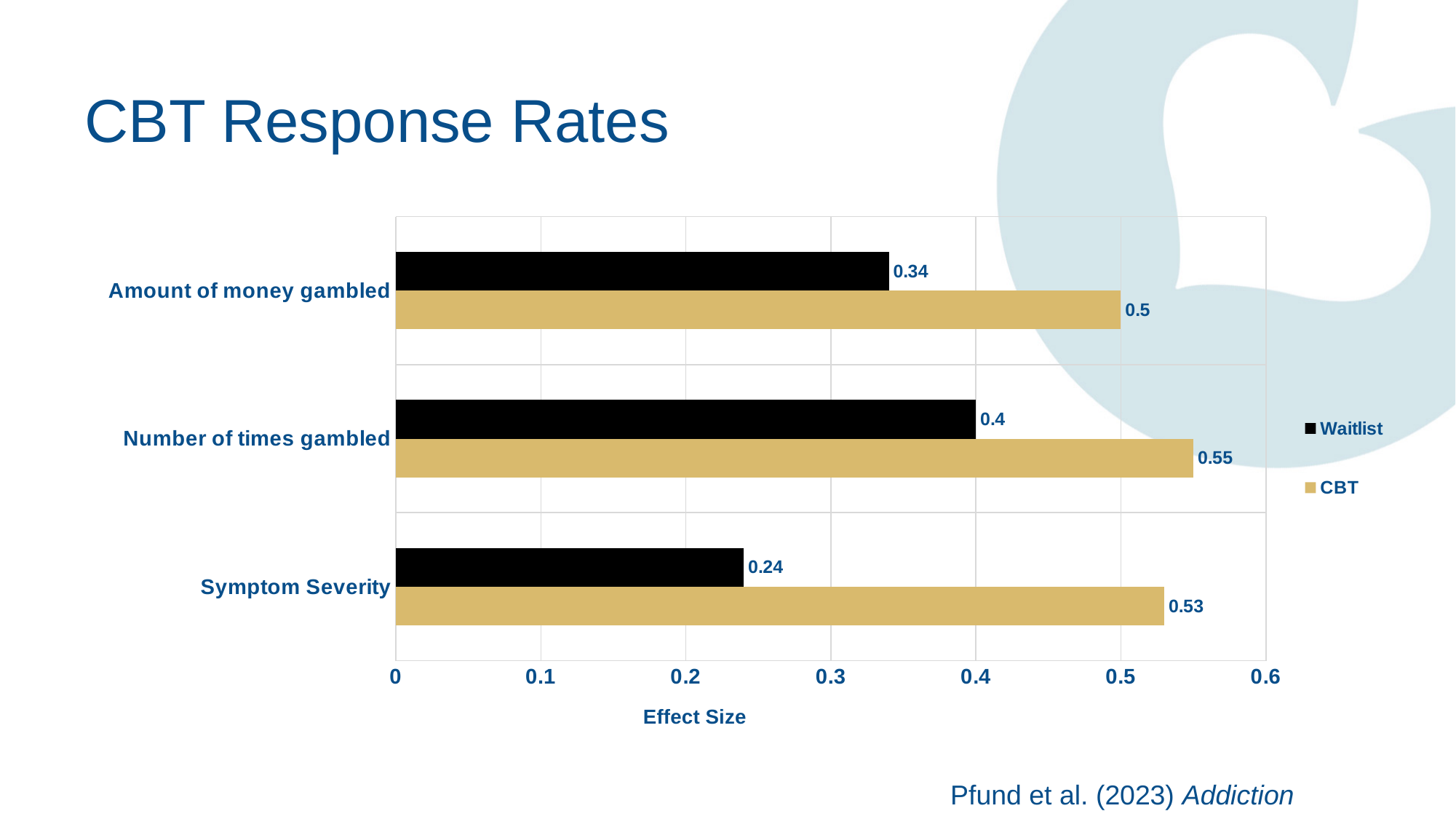
Which is larger for Number of times gambled, the CBT or the Waitlist effect size? CBT What is the difference between the CBT and Waitlist effect sizes for Symptom Severity? 0.29 How many categories are shown on the y axis? 3 What is the Waitlist effect size for Amount of money gambled? 0.34 What is the Waitlist effect size for Number of times gambled? 0.4 Which category has the highest CBT effect size? Number of times gambled What kind of chart is shown on the slide? Bar chart What is the difference between the CBT and Waitlist effect sizes for Amount of money gambled? 0.16 What is the label of the x axis? Effect Size How many series does the legend list? 2 Which category has the lowest Waitlist effect size? Symptom Severity What is the CBT effect size for Symptom Severity? 0.53